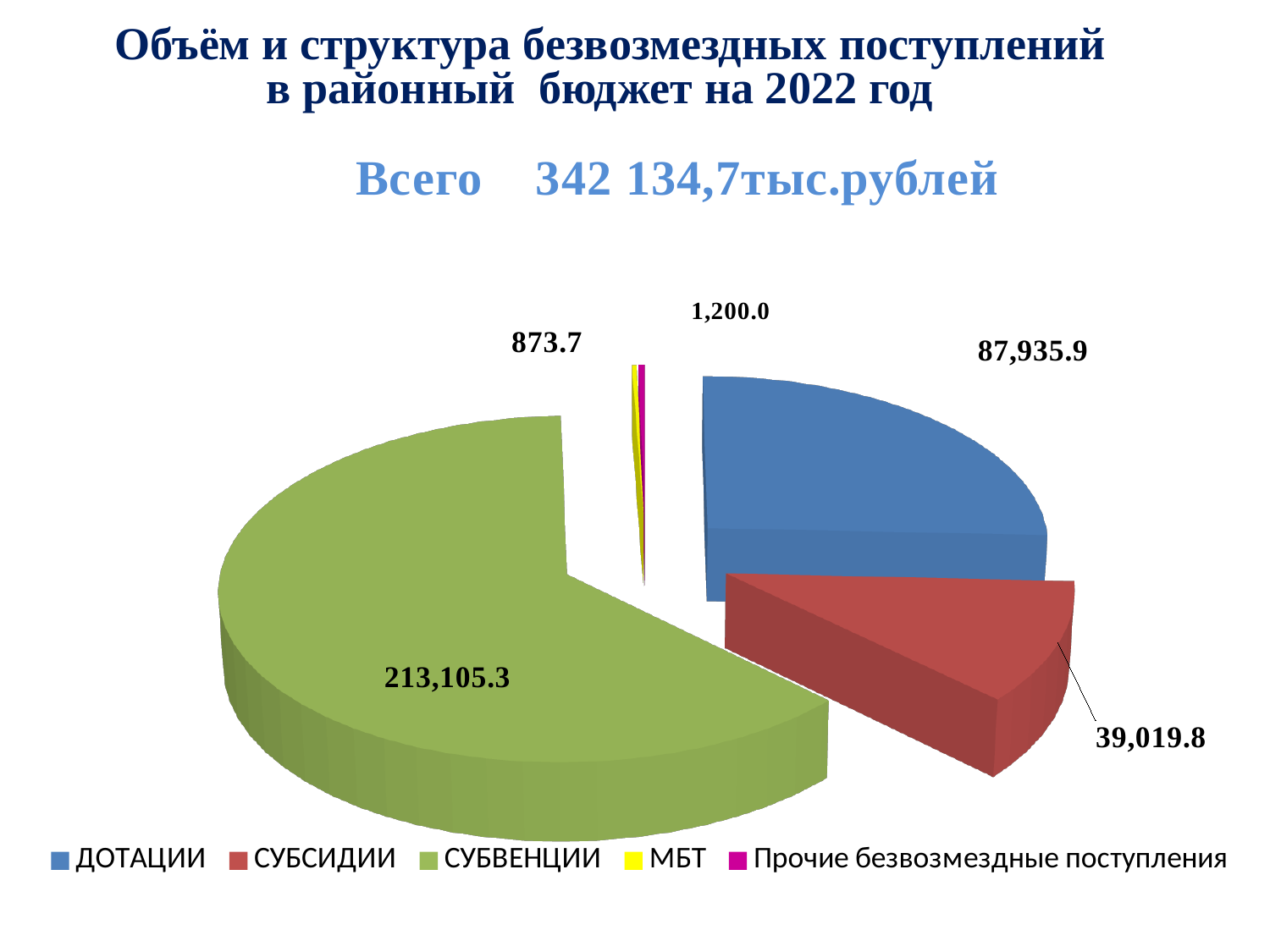
What is the value of the ДОТАЦИИ slice? 87,935.9 What is the value of the Прочие безвозмездные поступления slice? 1,200.0 What type of chart is shown on the slide? Pie chart Which category has the smallest slice of the pie? МБТ What is the value of the СУБСИДИИ slice? 39,019.8 What is the value of the МБТ slice? 873.7 Which category has the largest slice of the pie? СУБВЕНЦИИ What is the value of the СУБВЕНЦИИ slice? 213,105.3 How many slices does the pie chart have? 5 What is the difference between the СУБВЕНЦИИ and ДОТАЦИИ values? 125,169.4 What is the difference between the ДОТАЦИИ and СУБСИДИИ values? 48,916.1 Which is larger, ДОТАЦИИ or СУБСИДИИ? ДОТАЦИИ